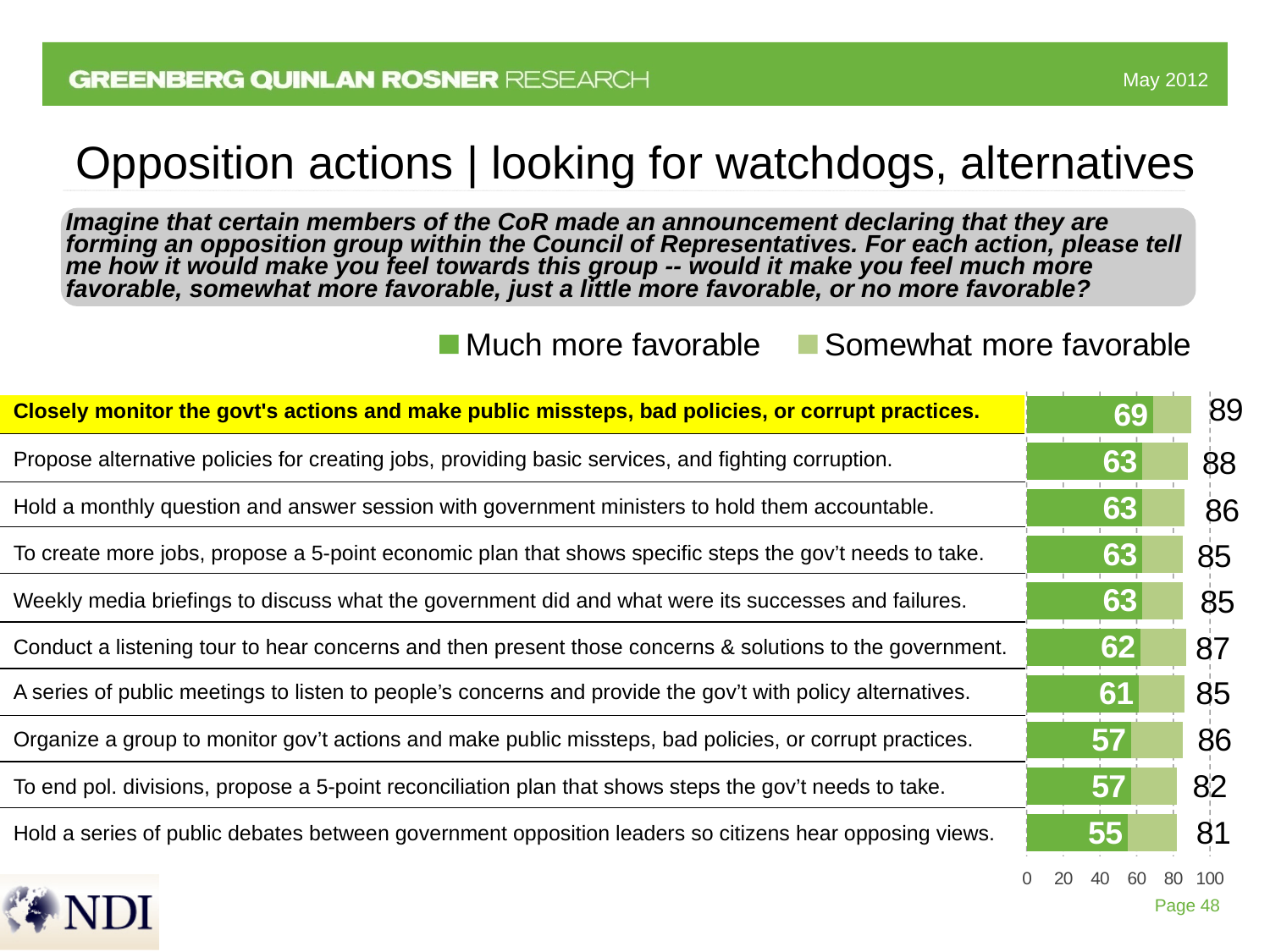
Which series is shown in the darker green colour in the legend? Much more favorable What is the 'Much more favorable' value for 'Hold a series of public debates between government opposition leaders so citizens hear opposing views'? 55 Which action has the lowest combined total shown at the right of the bars? Hold a series of public debates between government opposition leaders so citizens hear opposing views. What is the 'Much more favorable' value for 'Closely monitor the govt's actions and make public missteps, bad policies, or corrupt practices'? 69 Which action has the highest 'Much more favorable' value? Closely monitor the govt's actions and make public missteps, bad policies, or corrupt practices. How many series does the legend list? 2 Which has a larger 'Much more favorable' value: 'A series of public meetings to listen to people's concerns...' or 'Organize a group to monitor gov't actions...'? A series of public meetings to listen to people's concerns and provide the gov't with policy alternatives. How many actions (categories) are plotted in the chart? 10 What is the total (much more plus somewhat more favorable) for 'Conduct a listening tour to hear concerns and then present those concerns & solutions to the government'? 87 What is the difference between the 'Much more favorable' values for 'Closely monitor the govt's actions...' and 'Hold a series of public debates...'? 14 Is the 'Much more favorable' value for 'To end pol. divisions, propose a 5-point reconciliation plan...' greater or less than 60? less What kind of chart is shown on the slide? stacked bar chart